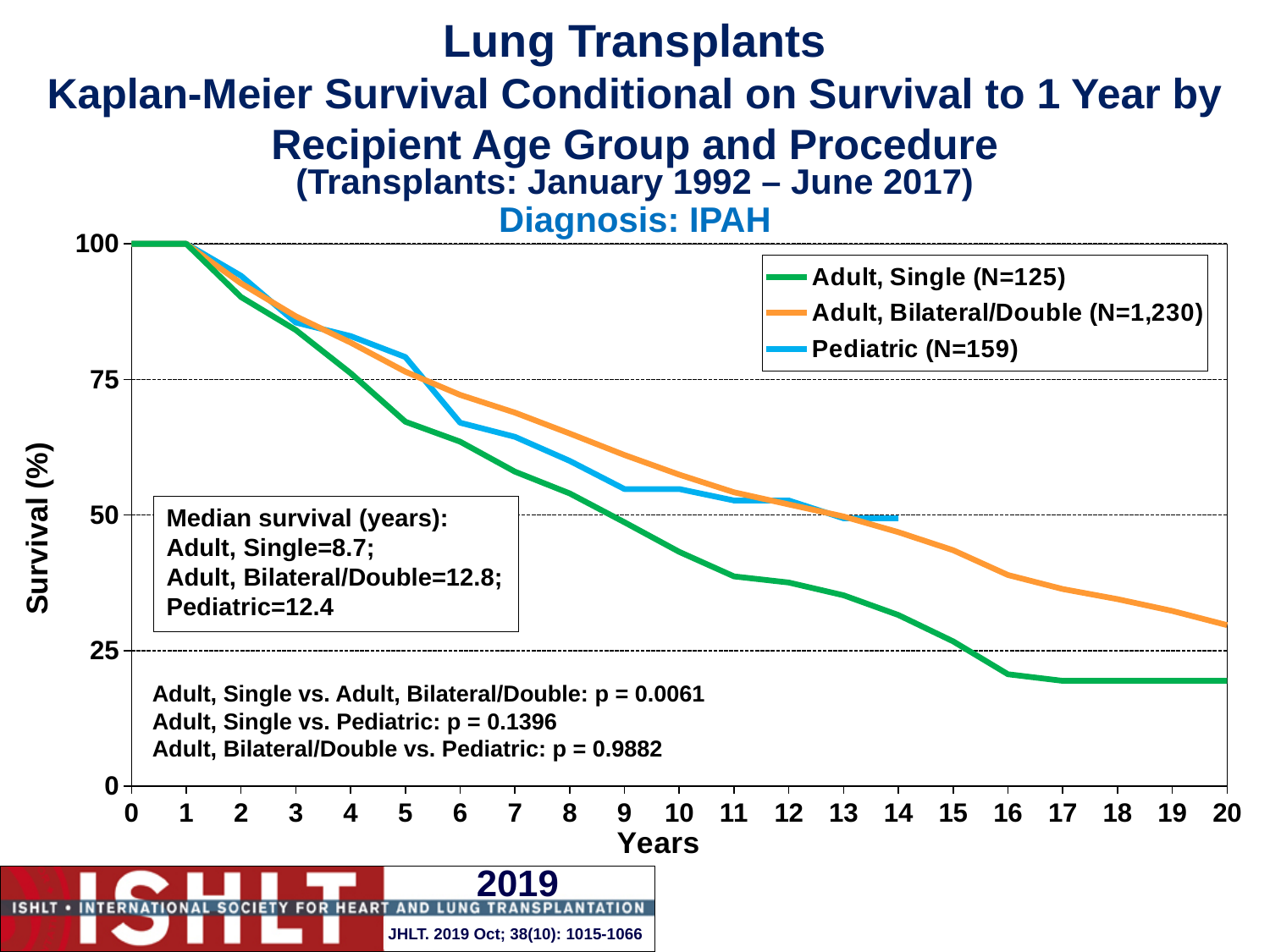
Which group has the longest median survival? Adult, Bilateral/Double What kind of chart is shown on the slide? line chart What is the difference in median survival (years) between Adult, Bilateral/Double and Adult, Single? 4.1 How many series does the legend list? 3 At 16 years, which curve is higher: Adult, Single or Adult, Bilateral/Double? Adult, Bilateral/Double What is the median survival in years for the Adult, Single group? 8.7 Do the survival curves rise or fall as years increase? fall Is the survival value for Adult, Bilateral/Double at 20 years greater or less than 25? greater What is the median survival in years for the Pediatric group? 12.4 What is the N for the Adult, Bilateral/Double group shown in the legend? 1,230 Which group has the shortest median survival? Adult, Single Is the survival value for Adult, Single at 16 years greater or less than 25? less